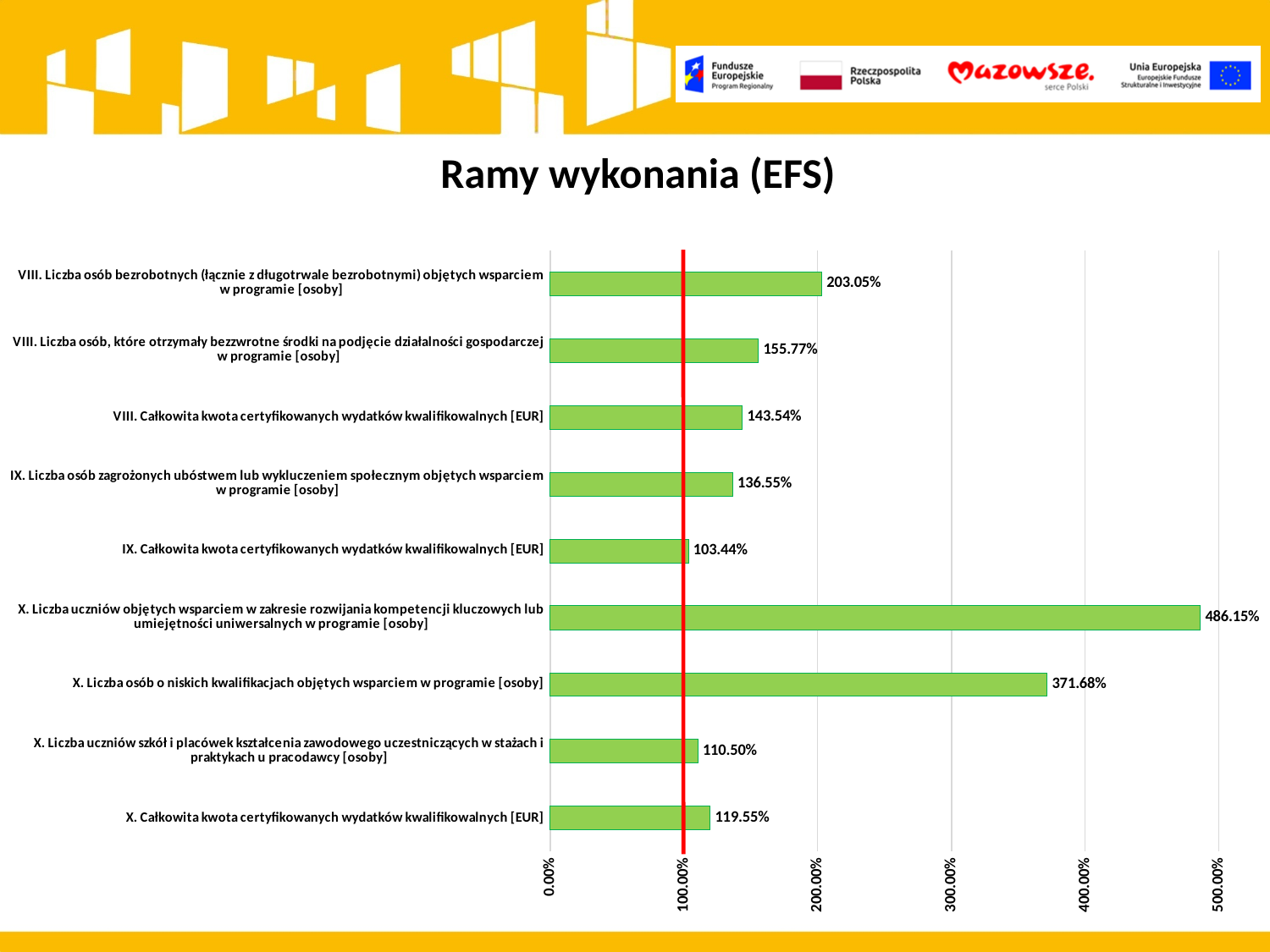
What type of chart is shown on the slide? Bar chart Which category has the lowest value? IX. Całkowita kwota certyfikowanych wydatków kwalifikowalnych [EUR] What is the difference between the values for "X. Liczba uczniów objętych wsparciem w zakresie rozwijania kompetencji kluczowych lub umiejętności uniwersalnych w programie [osoby]" and "X. Liczba osób o niskich kwalifikacjach objętych wsparciem w programie [osoby]"? 114.47% What is the value for "VIII. Liczba osób bezrobotnych (łącznie z długotrwale bezrobotnymi) objętych wsparciem w programie [osoby]"? 203.05% Which is larger: the value for "X. Liczba uczniów szkół i placówek kształcenia zawodowego uczestniczących w stażach i praktykach u pracodawcy [osoby]" or the value for "X. Całkowita kwota certyfikowanych wydatków kwalifikowalnych [EUR]"? X. Całkowita kwota certyfikowanych wydatków kwalifikowalnych [EUR] How many categories are plotted in the chart? 9 What is the difference between the values for "VIII. Całkowita kwota certyfikowanych wydatków kwalifikowalnych [EUR]" and "X. Całkowita kwota certyfikowanych wydatków kwalifikowalnych [EUR]"? 23.99% What is the value for "IX. Całkowita kwota certyfikowanych wydatków kwalifikowalnych [EUR]"? 103.44% Is the value for "IX. Liczba osób zagrożonych ubóstwem lub wykluczeniem społecznym objętych wsparciem w programie [osoby]" greater or less than 200.00%? less Which category has the highest value? X. Liczba uczniów objętych wsparciem w zakresie rozwijania kompetencji kluczowych lub umiejętności uniwersalnych w programie [osoby] What is the title of the chart on the slide? Ramy wykonania (EFS) What is the value for "X. Liczba osób o niskich kwalifikacjach objętych wsparciem w programie [osoby]"? 371.68%